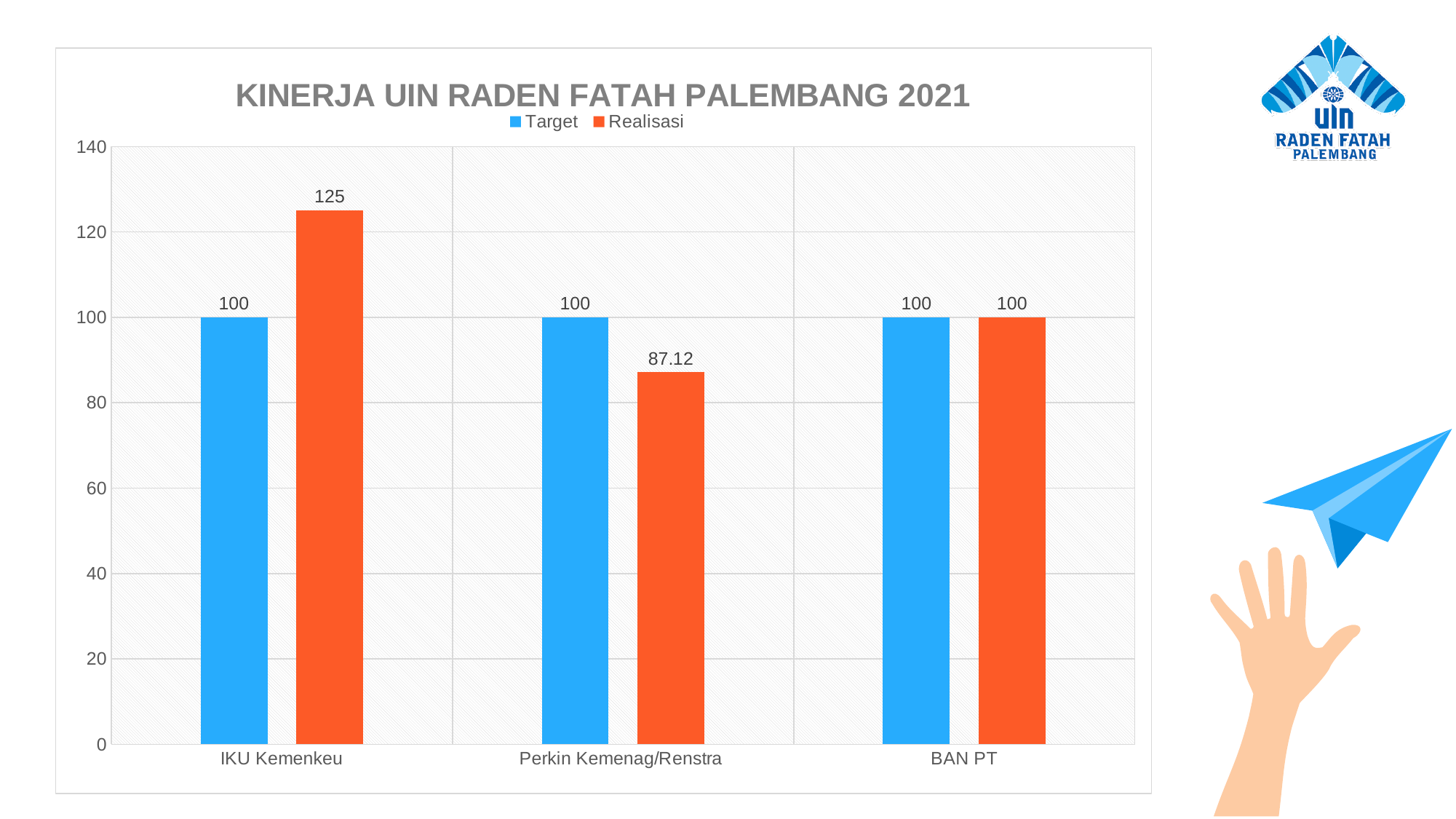
Which category has the lowest Realisasi value? Perkin Kemenag/Renstra How many series does the legend list? 2 Which category has the highest Realisasi value? IKU Kemenkeu How many categories are shown on the x axis? 3 For Perkin Kemenag/Renstra, which is larger: Target or Realisasi? Target What is the difference between the Realisasi and Target values for IKU Kemenkeu? 25 What is the Realisasi value for Perkin Kemenag/Renstra? 87.12 Is the Realisasi value for IKU Kemenkeu greater or less than 120? greater What is the Target value for BAN PT? 100 What type of chart is shown on the slide? Bar chart What is the difference between the Target and Realisasi values for Perkin Kemenag/Renstra? 12.88 What is the Realisasi value for IKU Kemenkeu? 125